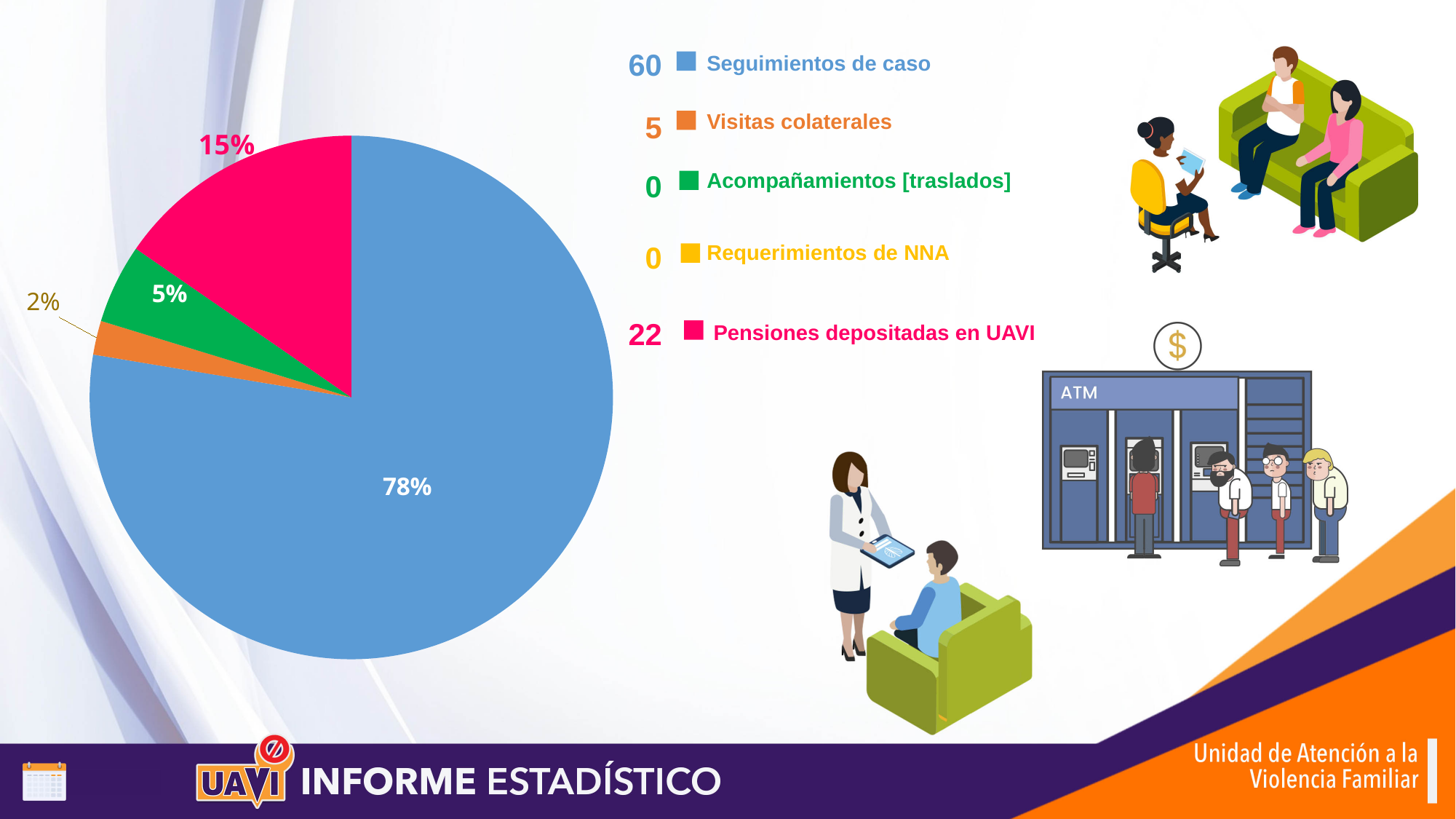
What number is shown next to Visitas colaterales in the legend? 5 What share of the pie does Pensiones depositadas en UAVI represent? 15% What share of the pie does Visitas colaterales represent? 2% Which slice is larger, Pensiones depositadas en UAVI or Visitas colaterales? Pensiones depositadas en UAVI What share of the pie does Seguimientos de caso represent? 78% Which category has the largest slice of the pie? Seguimientos de caso How many entries does the legend list? 5 What number is shown next to Pensiones depositadas en UAVI in the legend? 22 What kind of chart is shown on the slide? pie chart What is the difference in percentage points between the Seguimientos de caso slice and the Pensiones depositadas en UAVI slice? 63 percentage points What number is shown next to Seguimientos de caso in the legend? 60